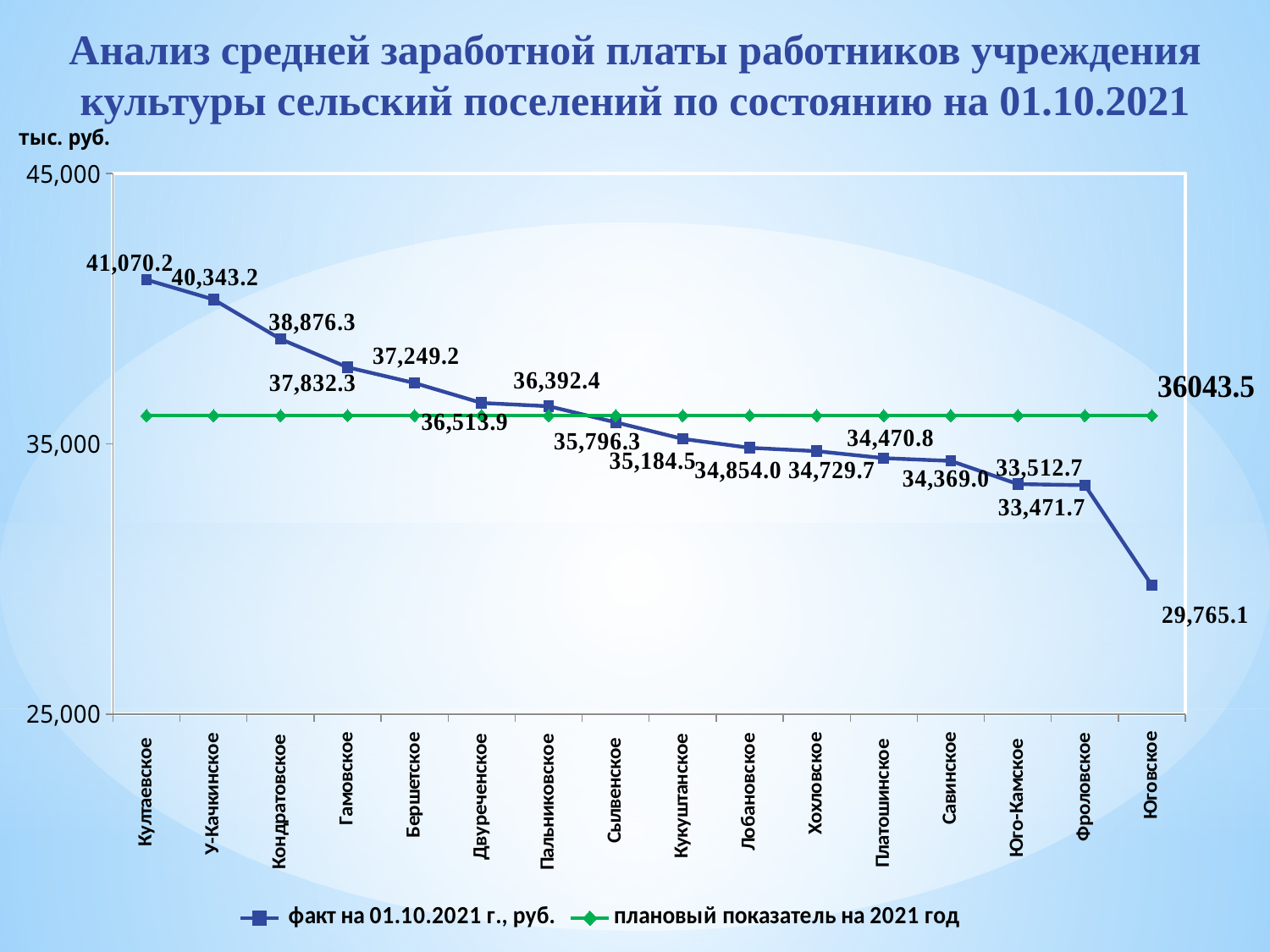
What is the value for Юговское in the 'факт на 01.10.2021 г., руб.' series? 29,765.1 Which is larger, the value for Кондратовское or the value for Гамовское? Кондратовское How many series does the legend list? 2 What is the difference between the values for Култаевское and У-Качкинское? 727.0 Which category has the highest value in the 'факт на 01.10.2021 г., руб.' series? Култаевское What is the value of the 'плановый показатель на 2021 год' line? 36043.5 Which category has the lowest value in the 'факт на 01.10.2021 г., руб.' series? Юговское What is the value for Култаевское in the 'факт на 01.10.2021 г., руб.' series? 41,070.2 How many categories are shown on the x axis? 16 Do the values of the 'факт на 01.10.2021 г., руб.' series rise or fall from left to right along the x axis? fall What kind of chart is shown on the slide? line chart Is the value for Юговское greater or less than 35,000? less